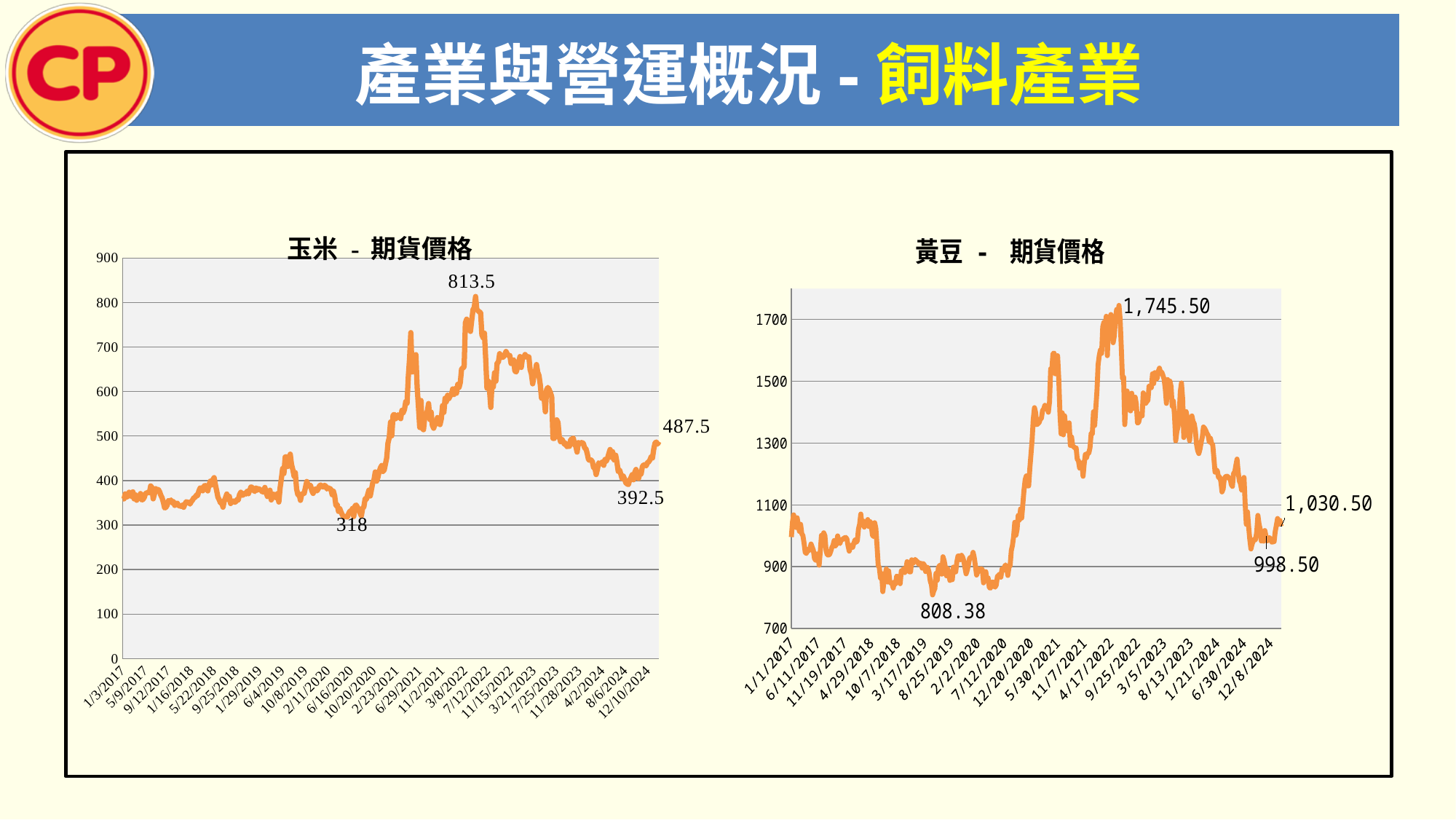
On the 黃豆 - 期貨價格 chart, what is the difference between the peak label 1,745.50 and the low label 808.38? 937.12 On the 玉米 - 期貨價格 chart, what is the difference between the peak label 813.5 and the low label 318? 495.5 On the 玉米 - 期貨價格 chart, which is larger: the labelled value 392.5 or the labelled value 487.5? 487.5 On the 黃豆 - 期貨價格 chart, what is the last labelled value at the right end of the line? 1,030.50 On the 玉米 - 期貨價格 chart, what is the last labelled value at the right end of the line? 487.5 On the 黃豆 - 期貨價格 chart, what is the highest labelled value? 1,745.50 What kind of chart is the 玉米 - 期貨價格 chart? line chart On the 玉米 - 期貨價格 chart, what is the lowest labelled value? 318 On the 玉米 - 期貨價格 chart, what is the highest labelled value? 813.5 On the 玉米 - 期貨價格 chart, is the value at the start of the line (1/3/2017) greater or less than 500? less On the 黃豆 - 期貨價格 chart, what is the lowest labelled value? 808.38 How many charts are shown on the slide? 2